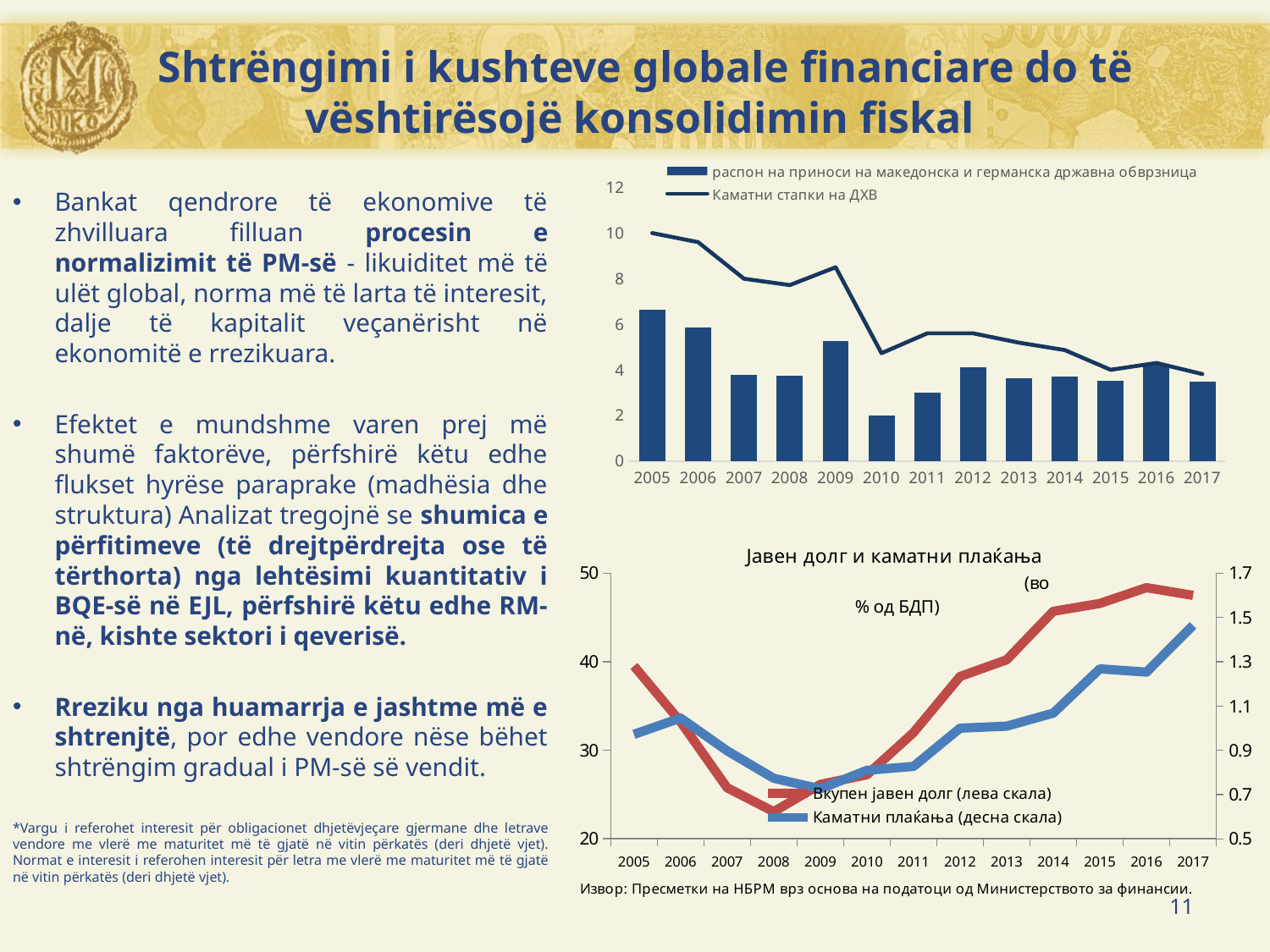
In the top chart, how many years are shown on the x axis? 13 In the top chart, what kind of chart is it? A combined bar and line chart In the top chart, which year has the highest value of the line series Каматни стапки на ДХВ? 2005 In the chart titled 'Јавен долг и каматни плаќања', which year has the lowest value of Вкупен јавен долг? 2008 In the top chart, is the line value (Каматни стапки на ДХВ) for 2005 greater or less than 8? greater In the chart titled 'Јавен долг и каматни плаќања', does Вкупен јавен долг rise or fall from 2010 to 2016? rise In the top chart, is the bar value for 2010 greater or less than 4? less In the chart titled 'Јавен долг и каматни плаќања', is the value of Вкупен јавен долг for 2016 greater or less than 40? greater In the chart titled 'Јавен долг и каматни плаќања', how many series does the legend list? 2 In the top chart, how many series does the legend list? 2 In the top chart, which year has the lowest bar? 2010 In the top chart, which year has the highest bar? 2005